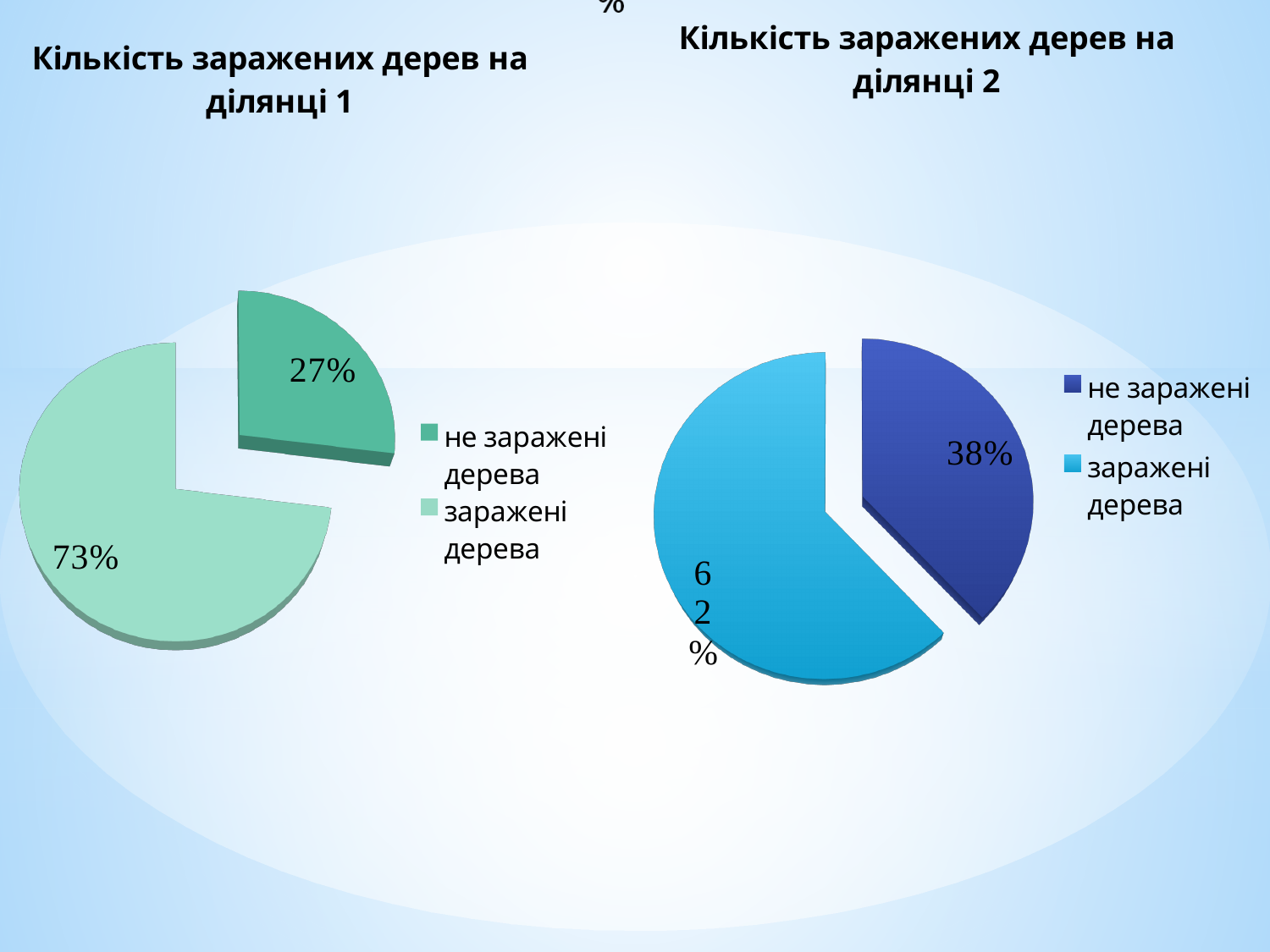
In the chart titled "Кількість заражених дерев на ділянці 2", which category has the smallest slice? не заражені дерева In the chart titled "Кількість заражених дерев на ділянці 1", what share of the pie is labelled for "не заражені дерева"? 27% In the chart titled "Кількість заражених дерев на ділянці 1", what is the difference in percentage points between "заражені дерева" and "не заражені дерева"? 46 What type of chart is the chart titled "Кількість заражених дерев на ділянці 2"? pie chart In the chart titled "Кількість заражених дерев на ділянці 1", which category has the largest slice? заражені дерева How many entries does the legend of the chart titled "Кількість заражених дерев на ділянці 2" list? 2 In the chart titled "Кількість заражених дерев на ділянці 1", what share of the pie is labelled for "заражені дерева"? 73% Which is larger: the "не заражені дерева" share in the chart for ділянка 1 or the "не заражені дерева" share in the chart for ділянка 2? ділянка 2 In the chart titled "Кількість заражених дерев на ділянці 2", what share of the pie is labelled for "не заражені дерева"? 38% In the chart titled "Кількість заражених дерев на ділянці 2", what share of the pie is labelled for "заражені дерева"? 62% In the chart titled "Кількість заражених дерев на ділянці 2", what is the difference in percentage points between "заражені дерева" and "не заражені дерева"? 24 How many slices does the chart titled "Кількість заражених дерев на ділянці 1" have? 2